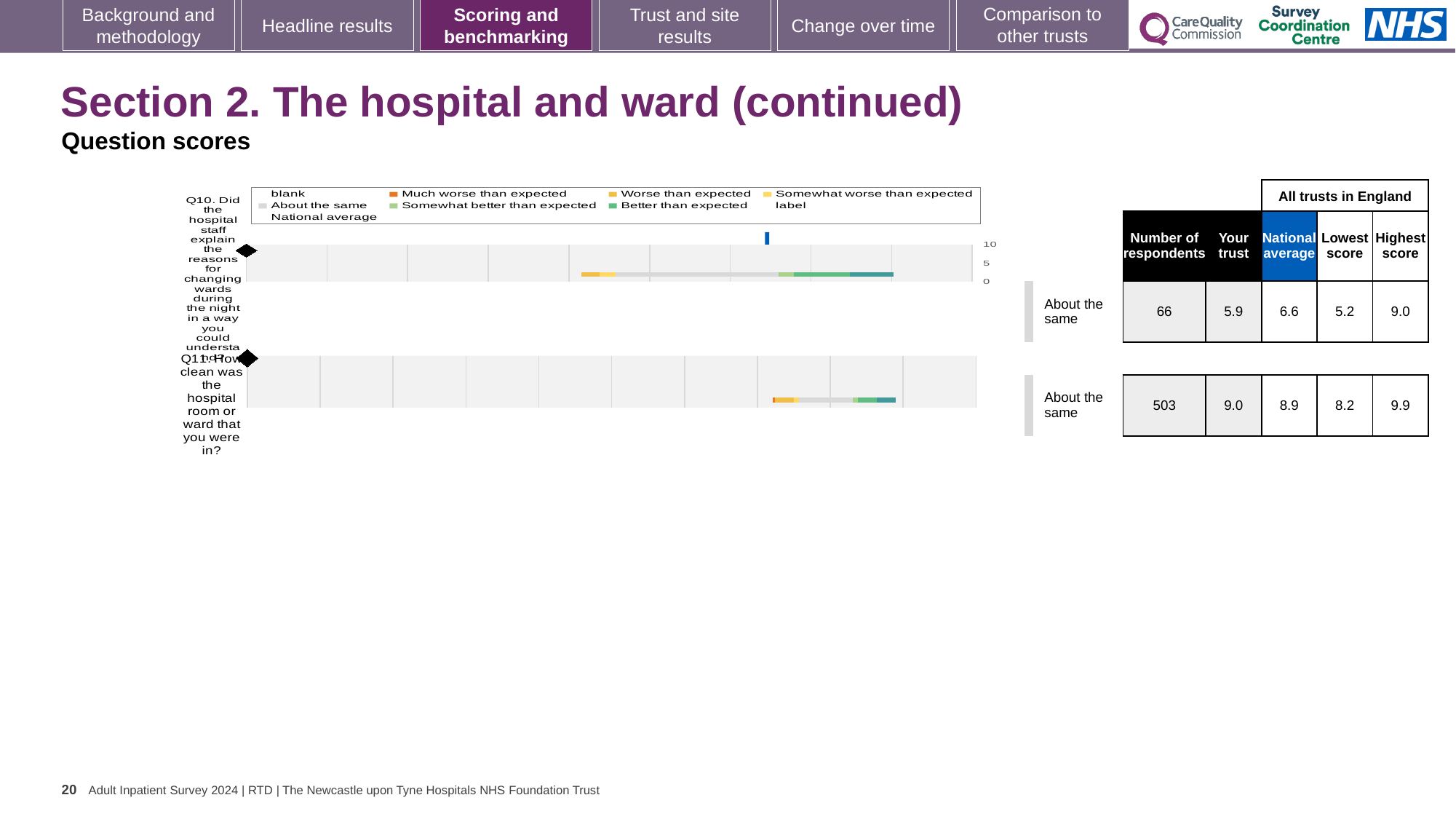
For Q10, what is the national average score? 6.6 For Q11, what is the difference between your trust's score and the national average? 0.1 For Q11 (how clean was the hospital room or ward), what is the score for your trust? 9.0 How many questions are plotted in the question scores charts on this slide? 2 What kind of chart is used to show the question scores on this slide? bar chart What benchmarking category label is shown next to the Q10 chart? About the same Which question has more respondents, Q10 or Q11? Q11 For Q10, what is the difference between the highest score and the lowest score among all trusts in England? 3.8 For Q11, how many respondents are there? 503 For Q11, what is the lowest score among all trusts in England? 8.2 For Q11, which is larger: your trust's score or the national average? Your trust For Q10 (explaining reasons for changing wards during the night), what is the score for your trust? 5.9